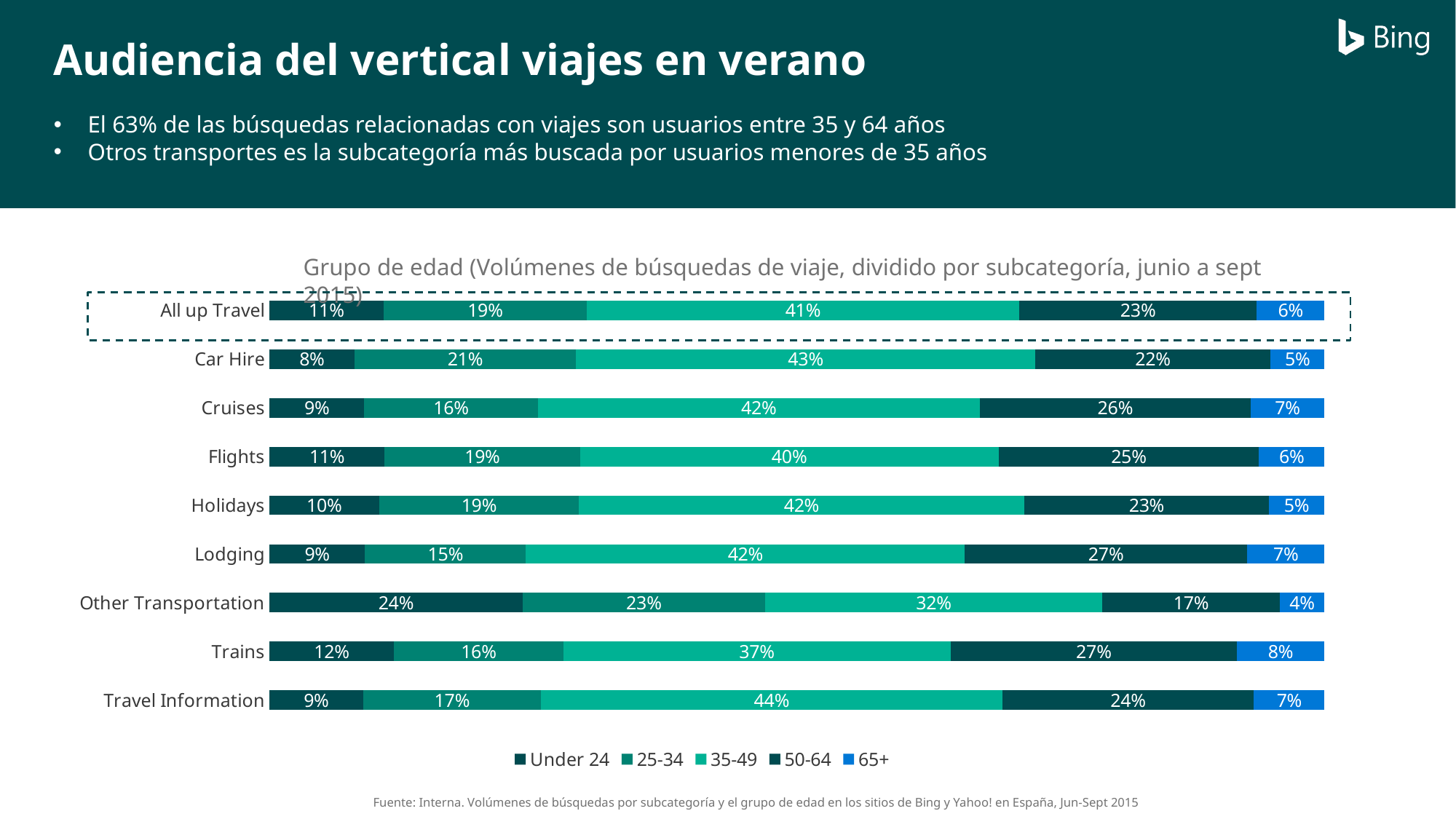
Which category has the highest value for the Under 24 age group? Other Transportation What is the value for the Under 24 age group in the Other Transportation category? 24% What is the difference between the 50-64 value for Lodging and the 50-64 value for Other Transportation? 10% What is the total of the All up Travel bar across all age groups? 100% What percentage of Car Hire searches come from the 35-49 age group? 43% Which category has the lowest value for the 65+ age group? Other Transportation What share of Trains searches is from users aged 65+? 8% What type of chart is shown on the slide? Stacked bar chart How many categories are shown on the chart? 9 Which category has the highest value for the 35-49 age group? Travel Information How many age groups does the legend list? 5 Which is larger: the 25-34 value for Car Hire or the 25-34 value for Cruises? Car Hire